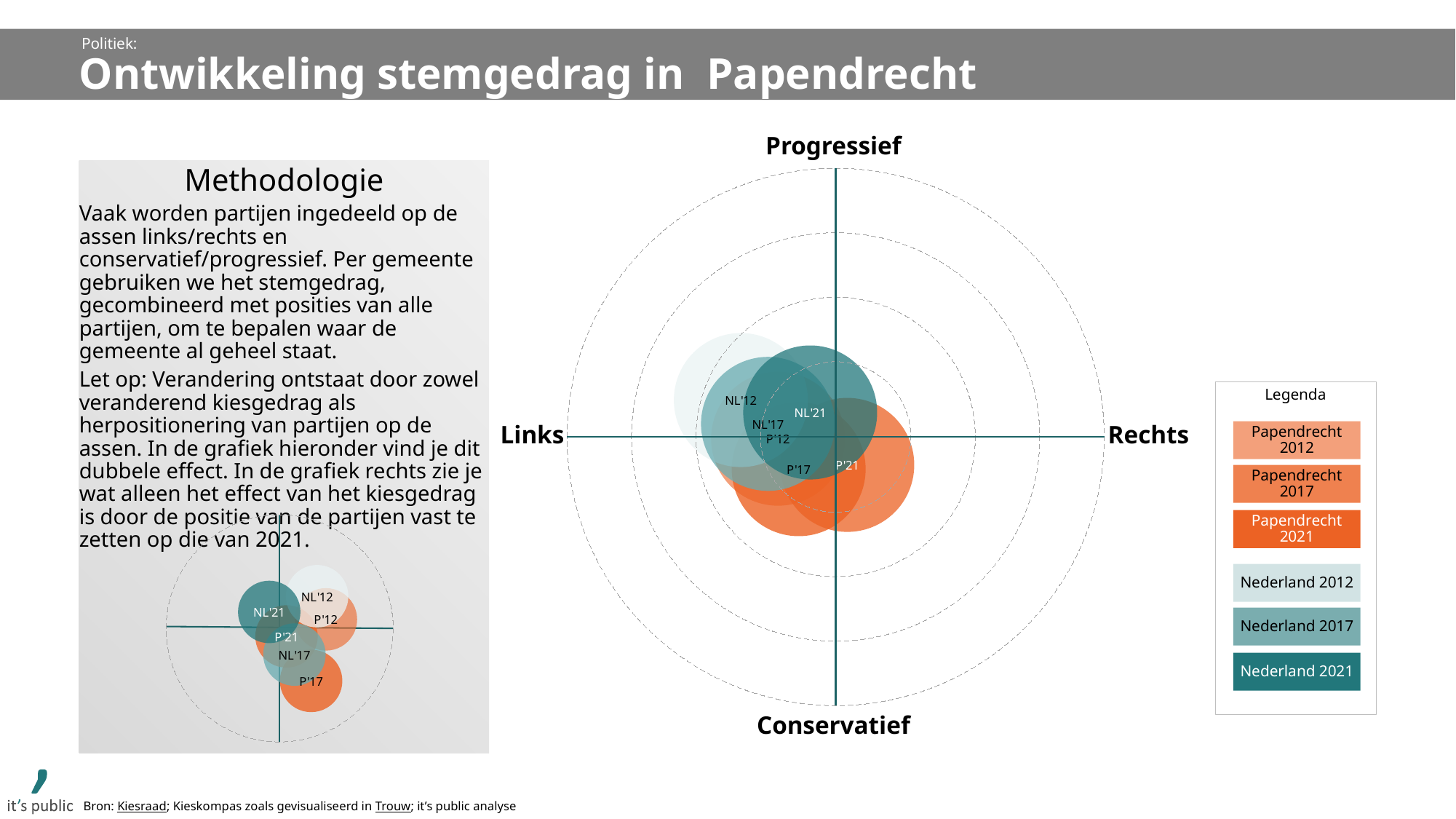
In the large chart on the right, which is positioned more towards 'Rechts': P'21 or NL'12? P'21 What kind of chart is the large chart on the right of the slide? Bubble chart In the large chart on the right, which bubble is positioned furthest to the left (most 'Links')? NL'12 In the large chart on the right, what are the labels at the top and bottom of the vertical axis? Progressief and Conservatief In the large chart on the right, which is positioned more towards 'Progressief': NL'12 or P'17? NL'12 In the small chart in the Methodologie box at the bottom left, which is positioned further to the left: NL'21 or P'12? NL'21 How many entries does the legend (Legenda) list? 6 In the small chart in the Methodologie box at the bottom left, which bubble is positioned lowest (most 'Conservatief')? P'17 In the large chart on the right, which bubble is positioned furthest to the right (most 'Rechts')? P'21 In the large chart on the right, what are the labels at the left and right ends of the horizontal axis? Links and Rechts How many labelled bubbles are plotted in the large chart on the right? 6